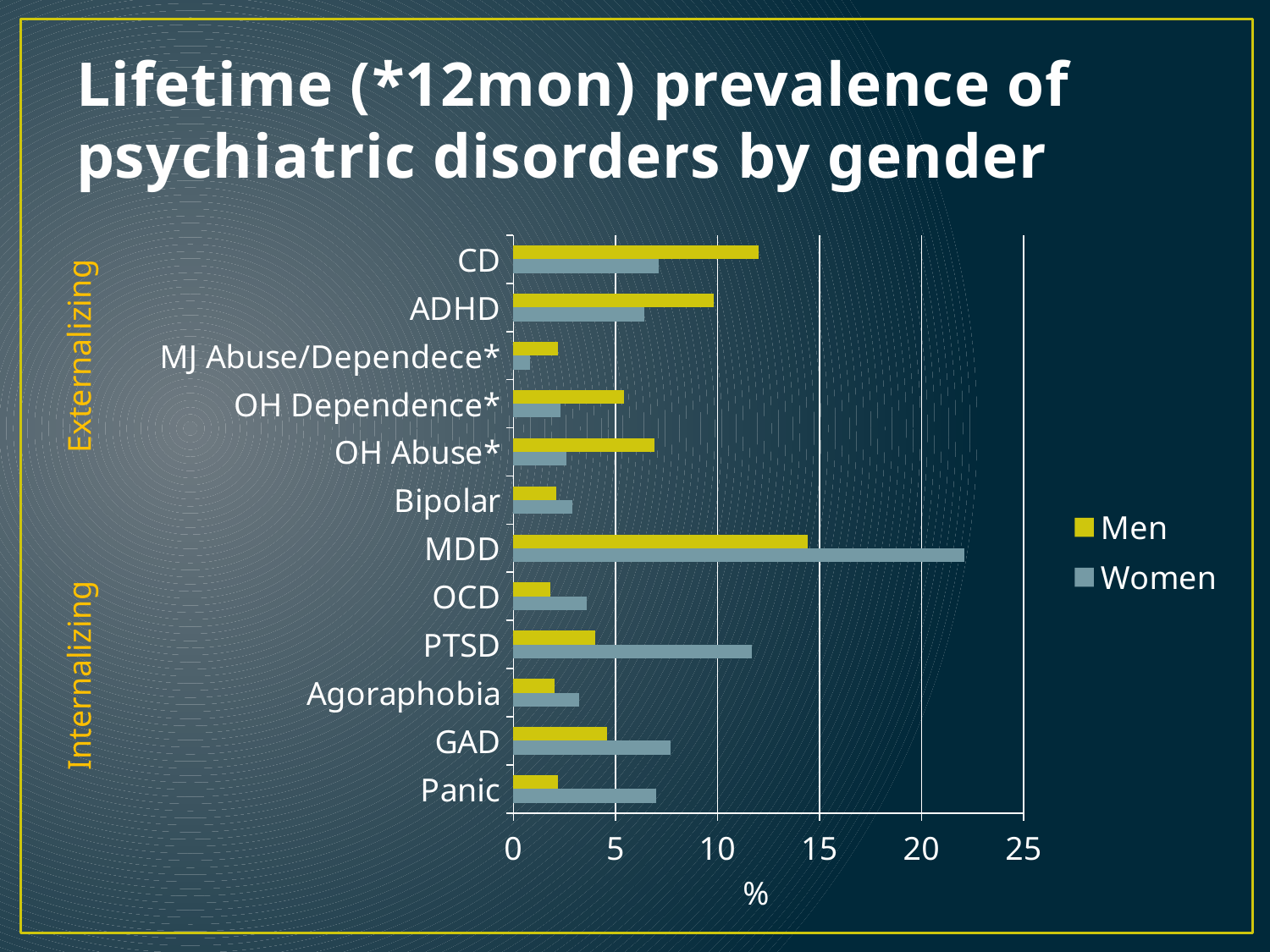
For PTSD, which is larger, the value for Men or the value for Women? Women Is the value for Women for MDD greater or less than 20? greater Is the value for Women for PTSD greater or less than 10? greater How many disorder categories are plotted on the chart? 12 Which disorder has the highest value for Men? MDD How many series does the legend list? 2 Is the value for Men for CD greater or less than 10? greater For CD, which is larger, the value for Men or the value for Women? Men What kind of chart is shown on the slide? bar chart Which disorder has the lowest value for Women? MJ Abuse/Dependece* Which disorder has the highest value for Women? MDD